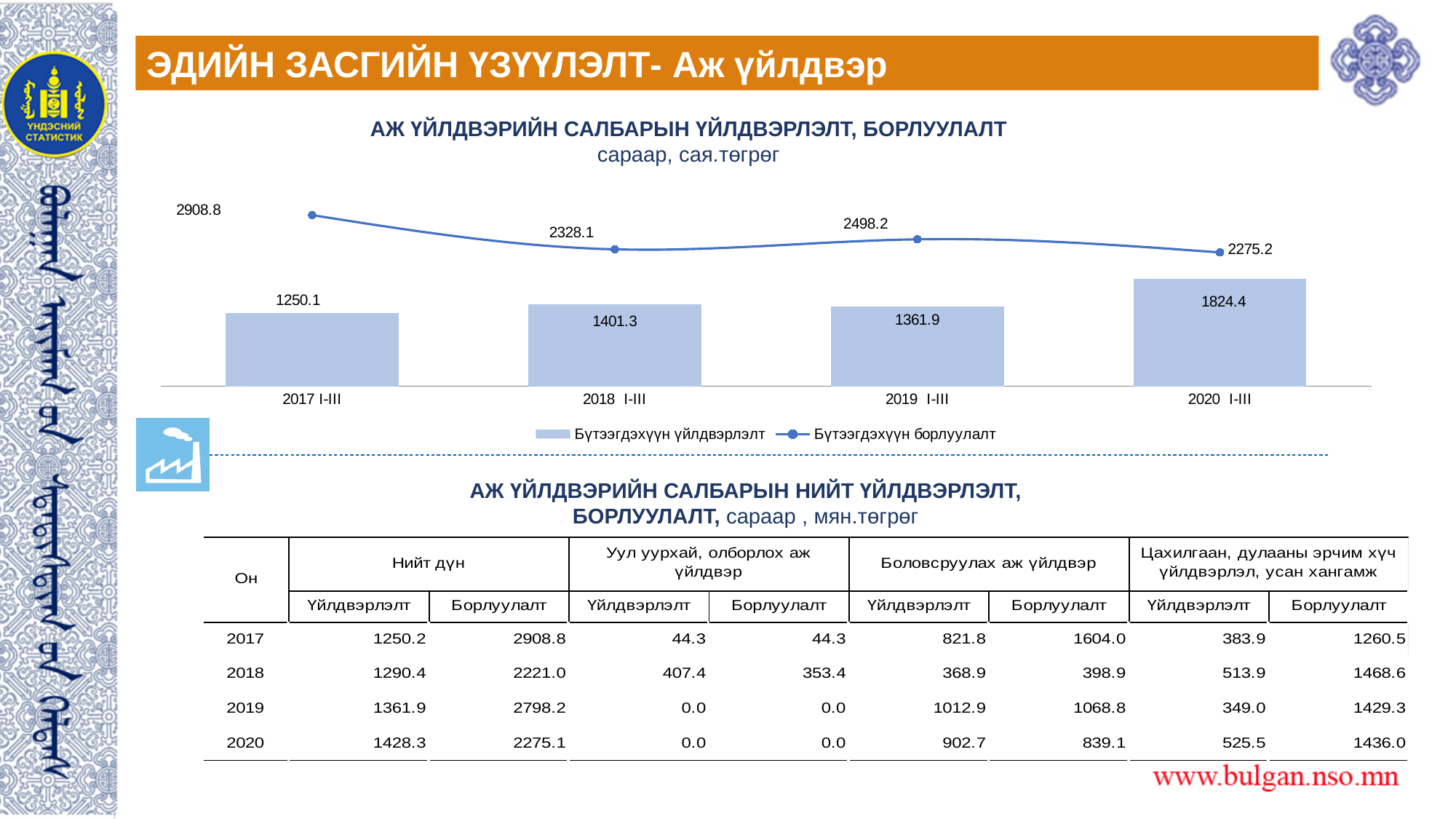
Which period has the highest Бүтээгдэхүүн үйлдвэрлэлт? 2020 I-III How many series does the chart legend list? 2 Which period has the lowest Бүтээгдэхүүн борлуулалт? 2020 I-III What is the value of Бүтээгдэхүүн борлуулалт for 2019 I-III? 2498.2 Which series is shown as a line in the chart? Бүтээгдэхүүн борлуулалт By how much does Бүтээгдэхүүн үйлдвэрлэлт in 2020 I-III exceed that in 2019 I-III? 462.5 Does Бүтээгдэхүүн борлуулалт rise or fall from 2017 I-III to 2018 I-III? Fall What kind of chart is shown on the slide? Combination bar and line chart What is the difference between Бүтээгдэхүүн борлуулалт in 2017 I-III and 2020 I-III? 633.6 How many periods are shown on the x axis of the chart? 4 What is the value of Бүтээгдэхүүн үйлдвэрлэлт for 2017 I-III? 1250.1 Which is larger, Бүтээгдэхүүн үйлдвэрлэлт in 2018 I-III or in 2019 I-III? 2018 I-III